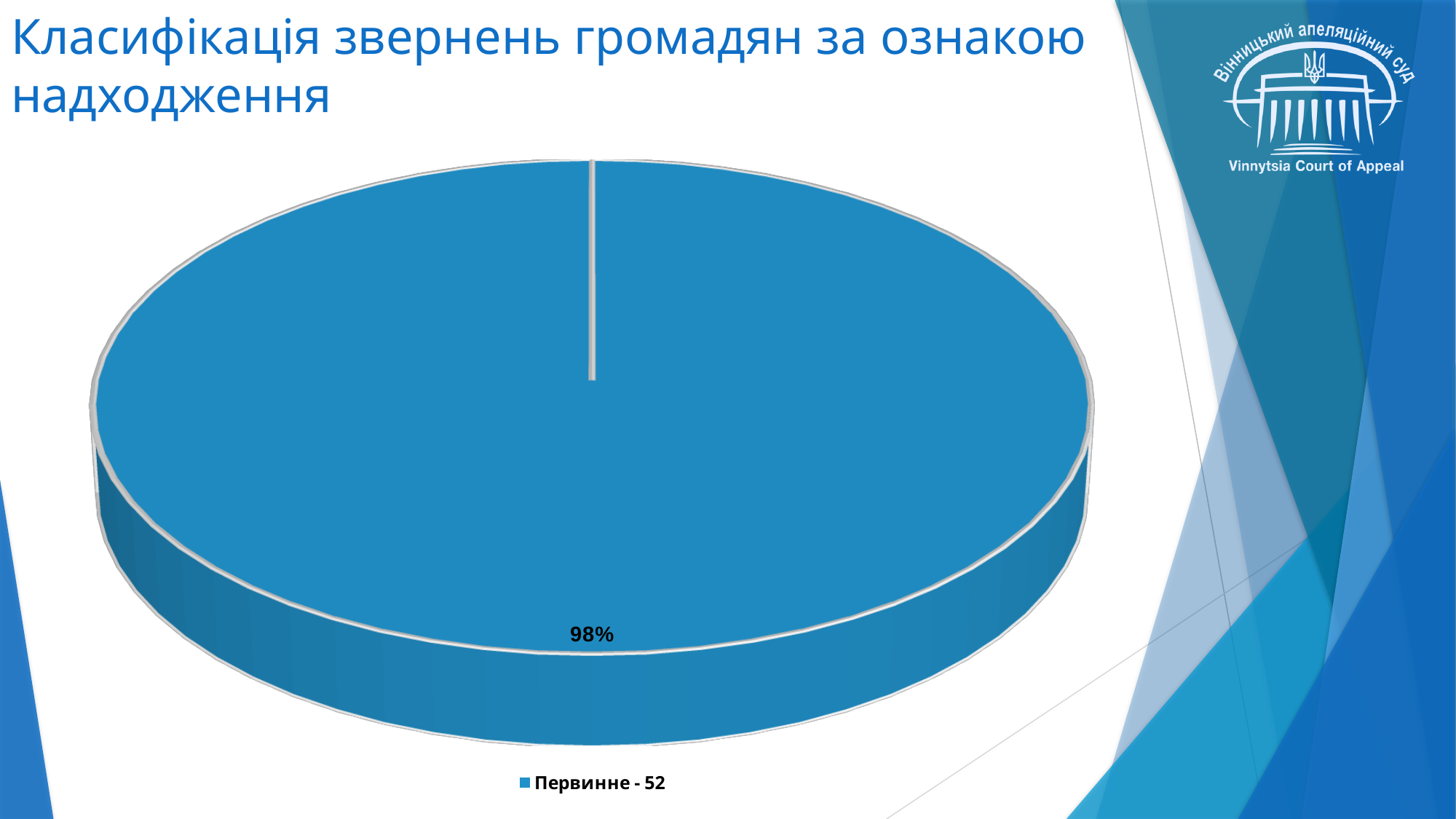
What is the legend entry shown below the pie chart? Первинне - 52 What share of the pie does the "Первинне - 52" slice represent? 98% What kind of chart is shown on the slide? pie chart What percentage label is printed on the pie chart? 98% What is the title of the slide containing the pie chart? Класифікація звернень громадян за ознакою надходження Is the share of the "Первинне - 52" slice greater or less than 50%? greater How many entries does the legend of the pie chart list? 1